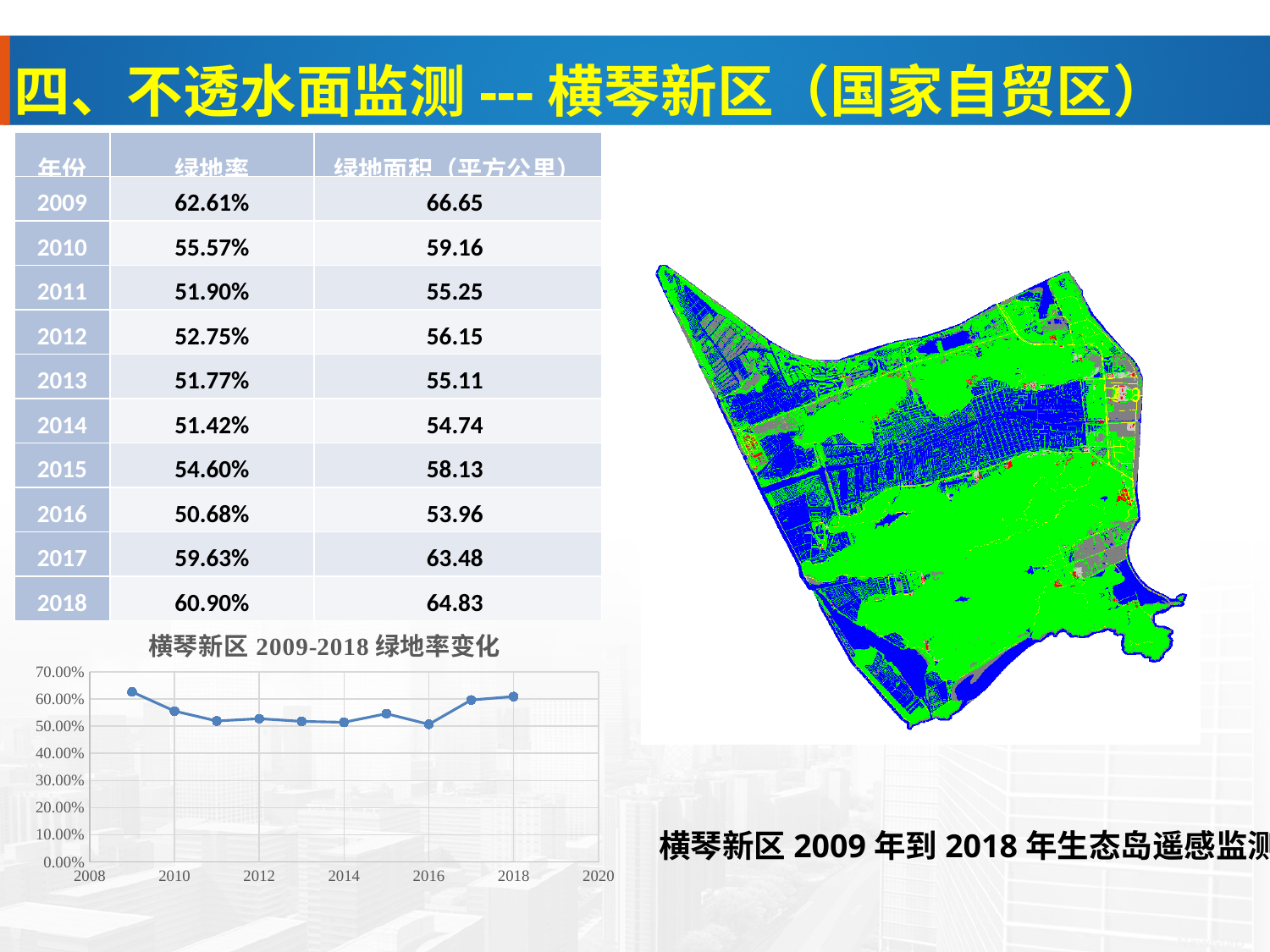
In the 横琴新区 2009-2018 绿地率变化 chart, which is larger, the value for 2009 or the value for 2016? 2009 What kind of chart is shown under the title 横琴新区 2009-2018 绿地率变化? line chart In the 横琴新区 2009-2018 绿地率变化 chart, is the value for 2016 greater or less than 60.00%? less In the 横琴新区 2009-2018 绿地率变化 chart, is the value for 2014 greater or less than 50.00%? greater According to the slide, what is the 绿地率 value plotted for 2009 in the 横琴新区 2009-2018 绿地率变化 chart? 62.61% In the 横琴新区 2009-2018 绿地率变化 chart, is the value for 2012 greater or less than 60.00%? less In the 横琴新区 2009-2018 绿地率变化 chart, which is larger, the value for 2017 or the value for 2014? 2017 In the 横琴新区 2009-2018 绿地率变化 chart, do the values rise or fall from 2009 to 2011? fall In the 横琴新区 2009-2018 绿地率变化 chart, which year has the highest green-space rate? 2009 In the 横琴新区 2009-2018 绿地率变化 chart, do the values rise or fall from 2016 to 2018? rise How many data points are plotted on the 横琴新区 2009-2018 绿地率变化 line chart? 10